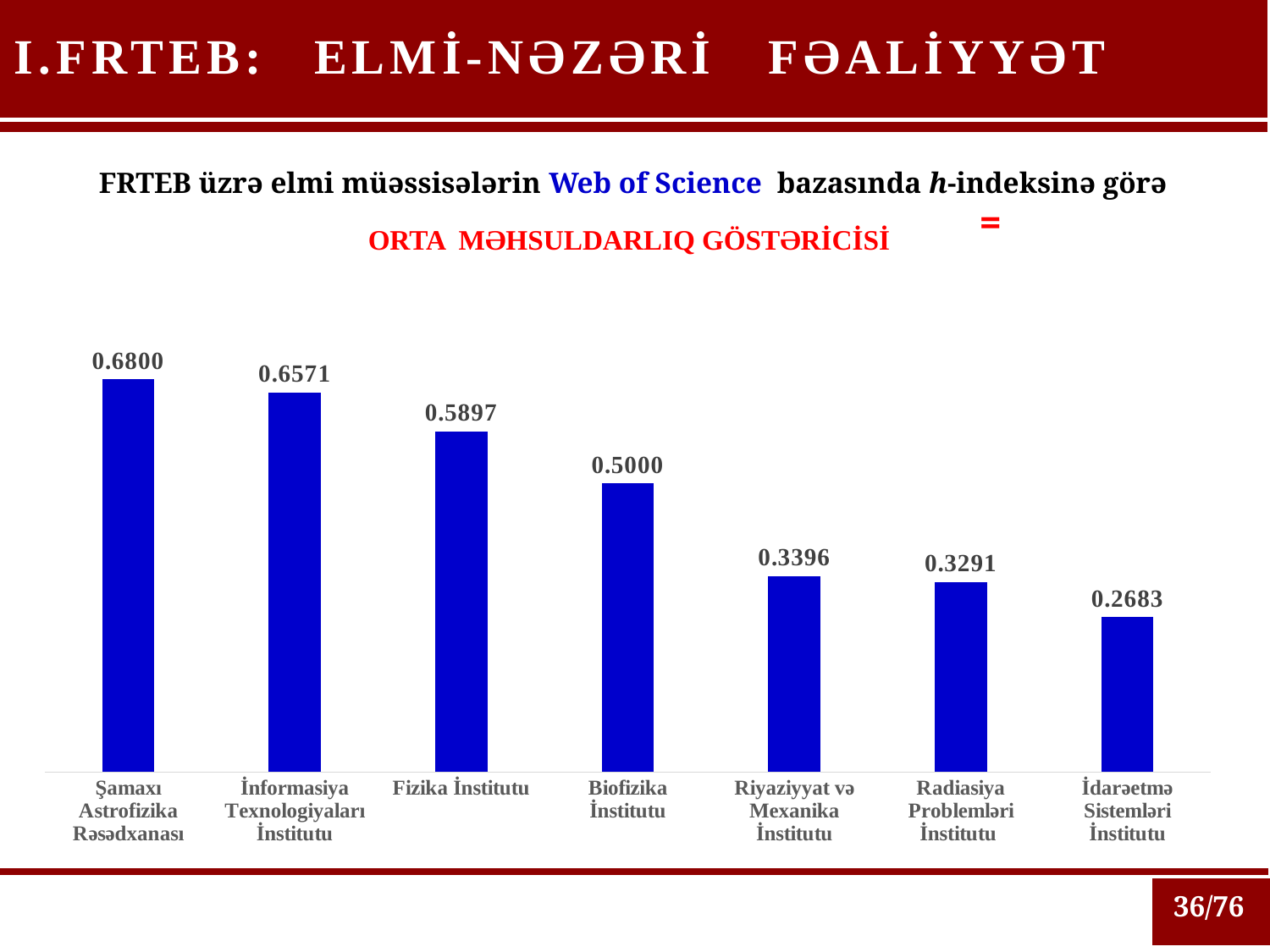
Which category has the highest value? Şamaxı Astrofizika Rəsədxanası What is the value for Radiasiya Problemləri İnstitutu? 0.3291 What is the difference between the values for Şamaxı Astrofizika Rəsədxanası and İdarəetmə Sistemləri İnstitutu? 0.4117 Do the values rise or fall from left to right along the x axis? Fall What is the value for Fizika İnstitutu? 0.5897 What colour are the bars in the chart? Blue Which is larger, the value for İnformasiya Texnologiyaları İnstitutu or the value for Riyaziyyat və Mexanika İnstitutu? İnformasiya Texnologiyaları İnstitutu What is the value for Biofizika İnstitutu? 0.5000 What kind of chart is shown on the slide? Bar chart Which category has the lowest value? İdarəetmə Sistemləri İnstitutu What is the difference between the values for Fizika İnstitutu and Biofizika İnstitutu? 0.0897 How many categories are shown in the chart? 7